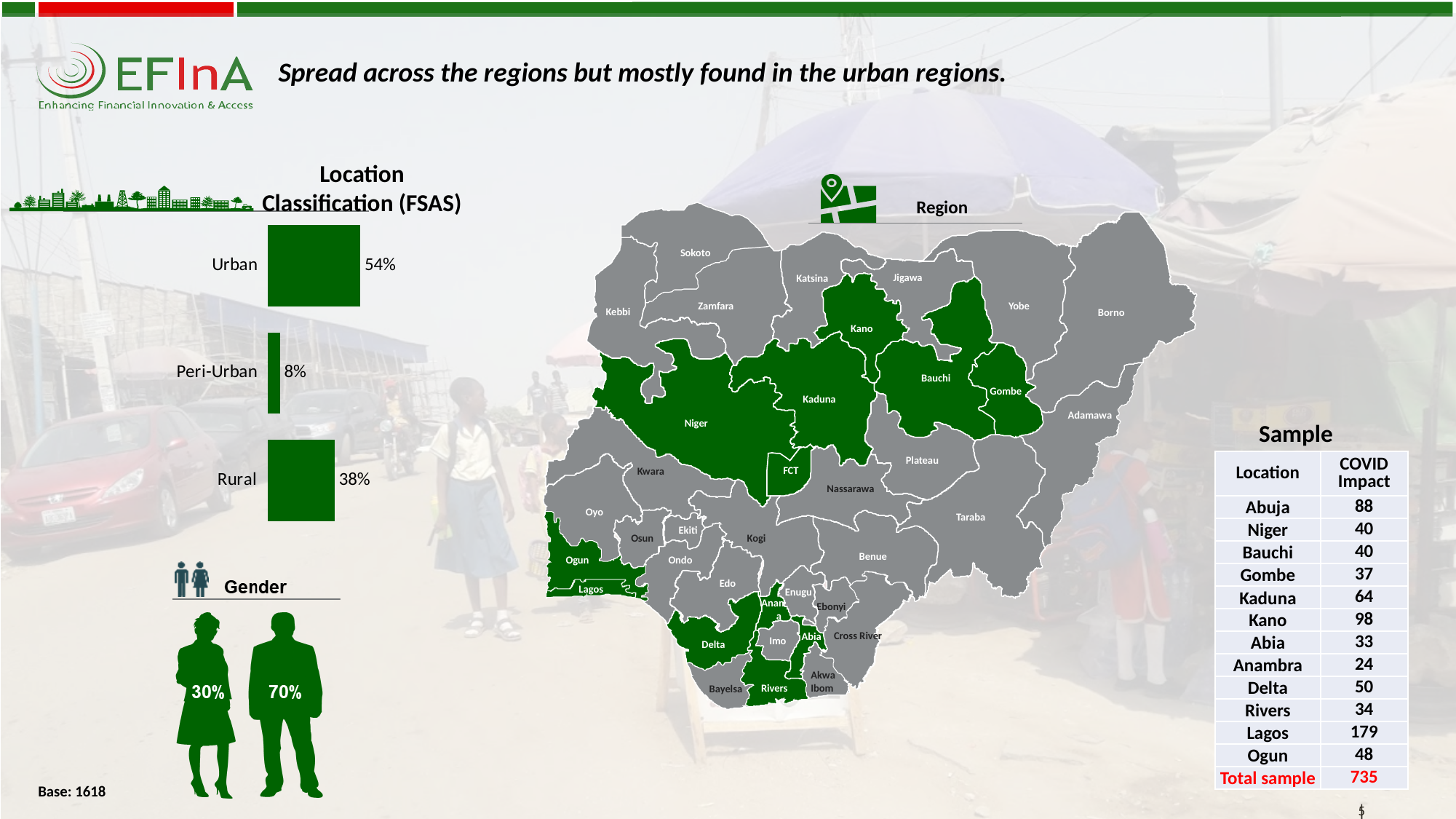
In the Location Classification (FSAS) chart, which category has the highest value? Urban What kind of chart is the Location Classification (FSAS) chart? Bar chart How many categories are shown in the Location Classification (FSAS) chart? 3 In the Location Classification (FSAS) chart, what is the difference between the Urban and Rural values? 16% In the Location Classification (FSAS) chart, which category has the lowest value? Peri-Urban What is the title of the bar chart on the left of the slide? Location Classification (FSAS) In the Location Classification (FSAS) chart, what is the value for Urban? 54% What colour are the bars in the Location Classification (FSAS) chart? Dark green In the Location Classification (FSAS) chart, what is the difference between the Rural and Peri-Urban values? 30% In the Location Classification (FSAS) chart, which is larger, Rural or Peri-Urban? Rural In the Location Classification (FSAS) chart, what is the value for Rural? 38% In the Location Classification (FSAS) chart, what is the value for Peri-Urban? 8%